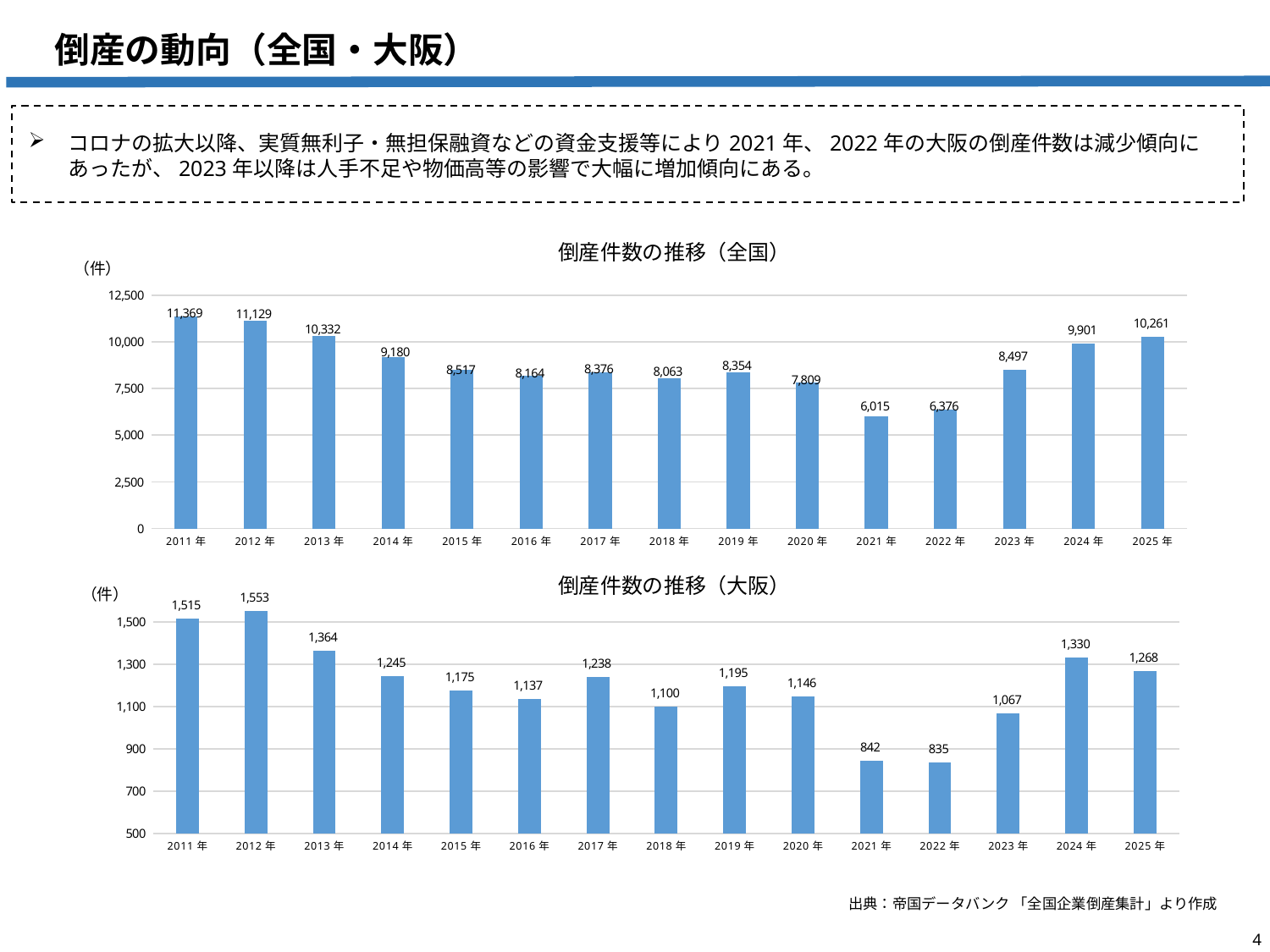
In the 倒産件数の推移（大阪） chart, do the values rise or fall from 2022年 to 2024年? rise In the 倒産件数の推移（全国） chart, what is the value for 2021年? 6,015 In the 倒産件数の推移（大阪） chart, what is the difference between the values for 2012年 and 2011年? 38 In the 倒産件数の推移（全国） chart, which year has the highest value? 2011年 In the 倒産件数の推移（全国） chart, which year has the lowest value? 2021年 What kind of chart is the 倒産件数の推移（全国） chart? bar chart In the 倒産件数の推移（全国） chart, what is the difference between the values for 2025年 and 2024年? 360 In the 倒産件数の推移（大阪） chart, which year has the highest value? 2012年 In the 倒産件数の推移（大阪） chart, which year has the lowest value? 2022年 In the 倒産件数の推移（大阪） chart, which is larger, the value for 2023年 or the value for 2025年? 2025年 In the 倒産件数の推移（大阪） chart, what is the value for 2024年? 1,330 In the 倒産件数の推移（全国） chart, how many years are plotted? 15